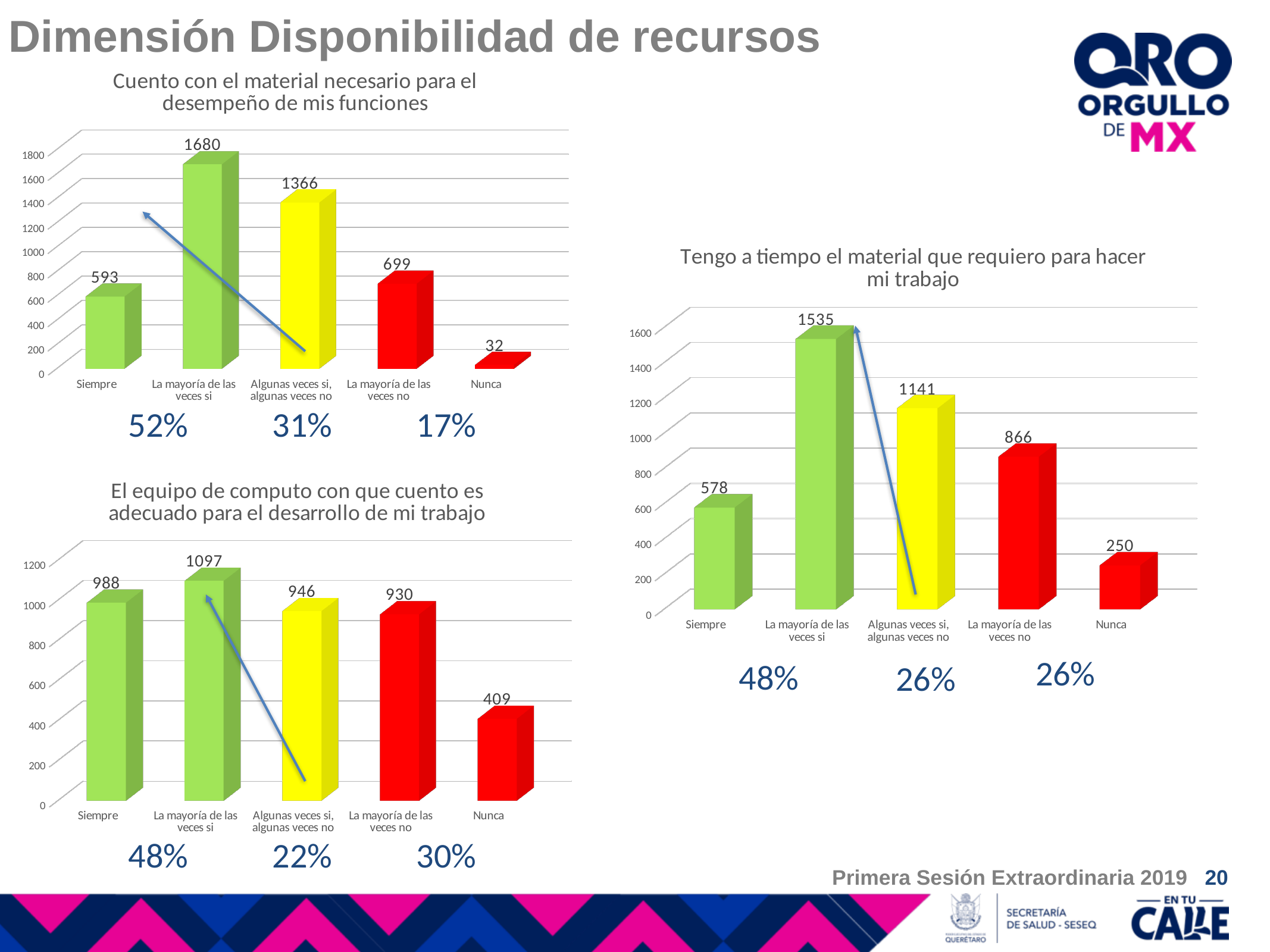
In the chart titled 'Cuento con el material necesario para el desempeño de mis funciones', what is the difference between 'La mayoría de las veces si' and 'Algunas veces si, algunas veces no'? 314 In the chart titled 'El equipo de computo con que cuento es adecuado para el desarrollo de mi trabajo', what is the difference between 'Algunas veces si, algunas veces no' and 'La mayoría de las veces no'? 16 What kind of chart is the one titled 'Tengo a tiempo el material que requiero para hacer mi trabajo'? Bar chart In the chart titled 'Cuento con el material necesario para el desempeño de mis funciones', what is the value for 'La mayoría de las veces si'? 1680 In the chart titled 'Tengo a tiempo el material que requiero para hacer mi trabajo', which category has the highest value? La mayoría de las veces si In the chart titled 'Cuento con el material necesario para el desempeño de mis funciones', which category has the lowest value? Nunca How many charts are shown on the slide? 3 In the chart titled 'Tengo a tiempo el material que requiero para hacer mi trabajo', what is the value for 'Nunca'? 250 In the chart titled 'El equipo de computo con que cuento es adecuado para el desarrollo de mi trabajo', which category has the highest value? La mayoría de las veces si In the chart titled 'Tengo a tiempo el material que requiero para hacer mi trabajo', which is larger: 'Siempre' or 'La mayoría de las veces no'? La mayoría de las veces no How many categories are shown in the chart titled 'El equipo de computo con que cuento es adecuado para el desarrollo de mi trabajo'? 5 In the chart titled 'El equipo de computo con que cuento es adecuado para el desarrollo de mi trabajo', what is the value for 'Siempre'? 988